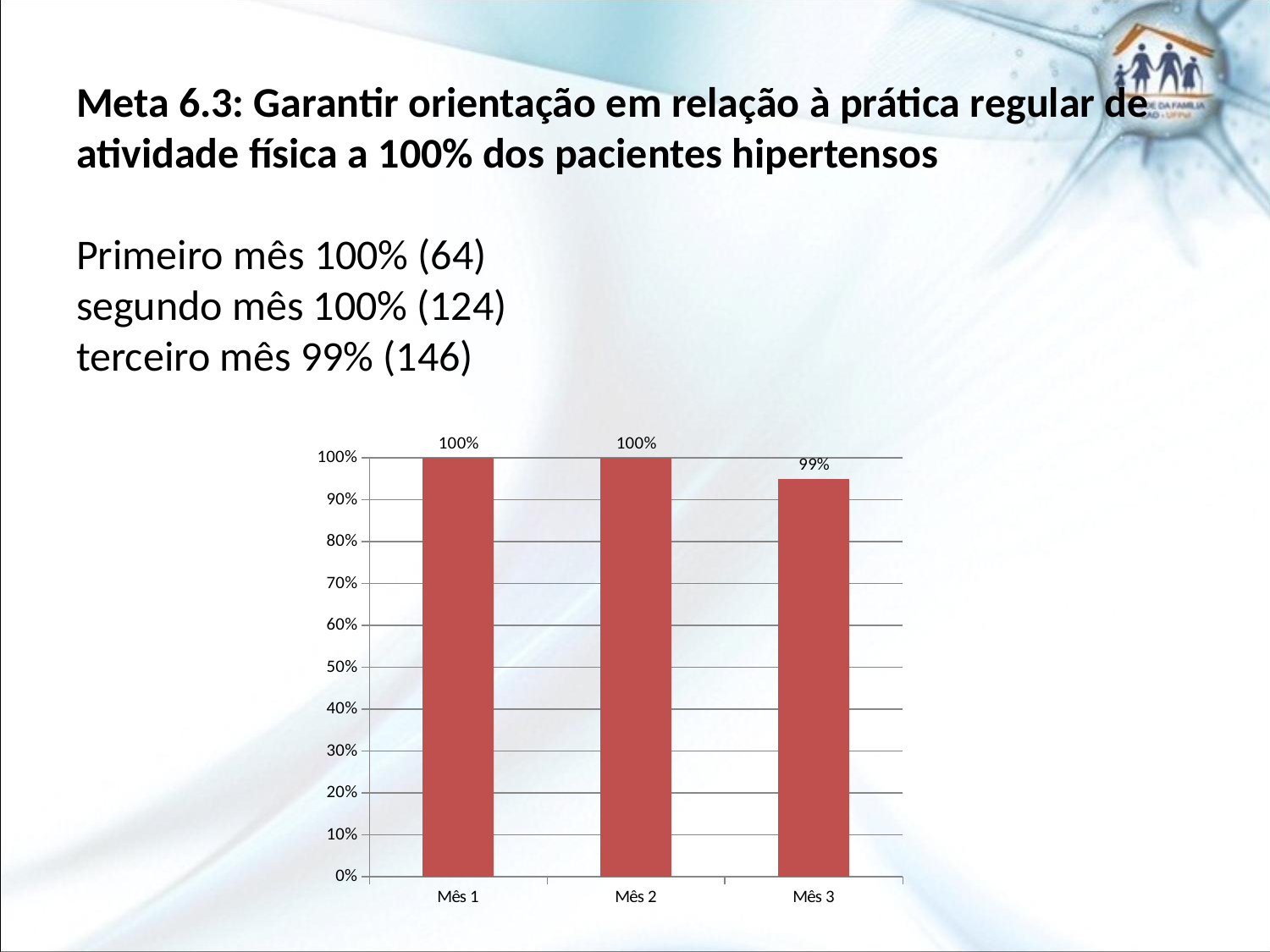
What colour are the bars in the chart? red What kind of chart is shown on the slide? bar chart What is the difference between the values for Mês 2 and Mês 3? 1% What is the value for Mês 1? 100% What is the value for Mês 3? 99% What is the highest tick value shown on the y axis? 100% How many categories are shown on the x axis? 3 What is the value for Mês 2? 100% Do the values rise or fall from Mês 2 to Mês 3? fall Which is larger, the value for Mês 1 or the value for Mês 3? Mês 1 Is the value for Mês 3 greater or less than 90%? greater Which month has the lowest value? Mês 3